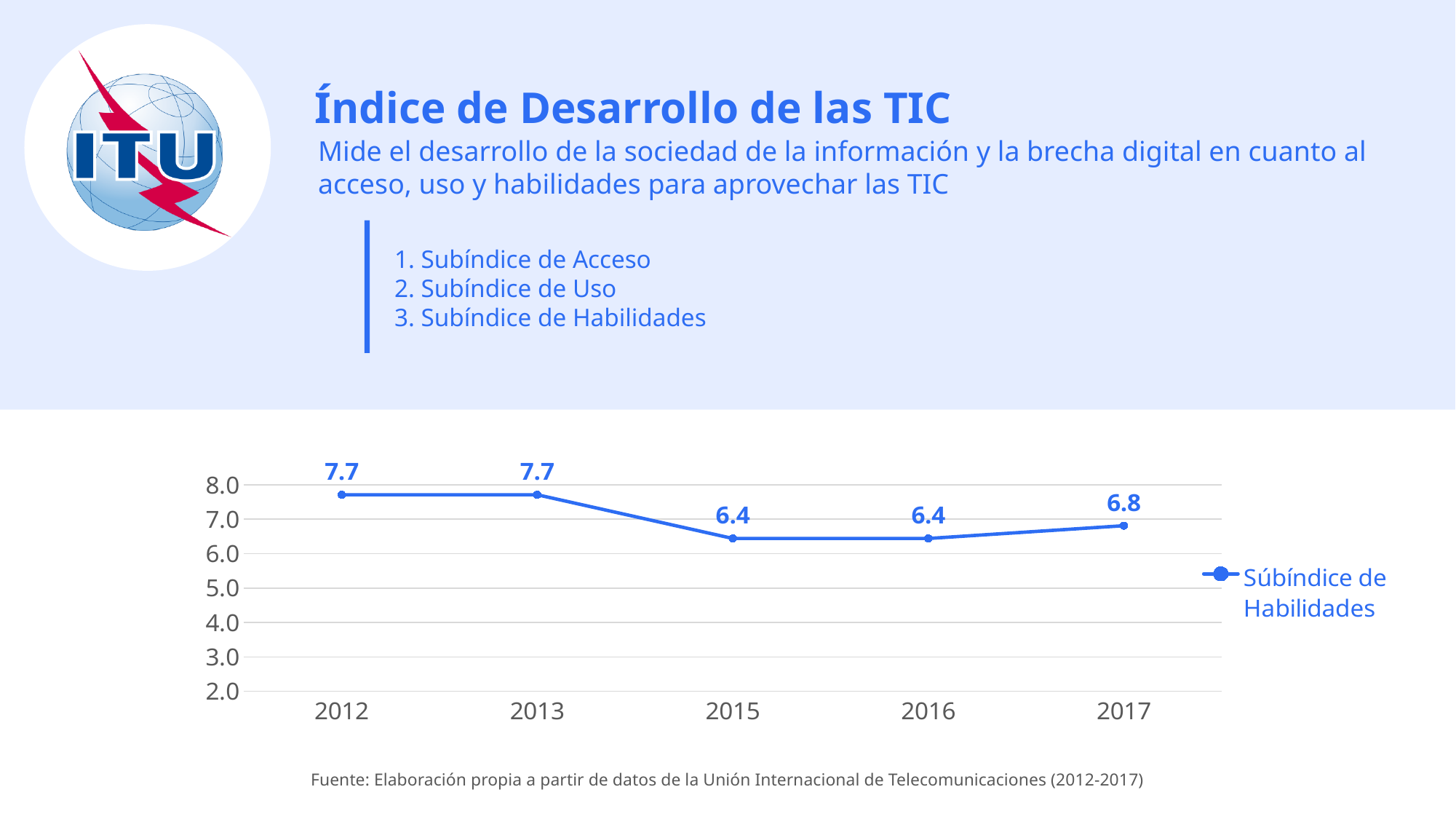
What is the value of the Subíndice de Habilidades in 2017? 6.8 Is the value for 2017 greater or less than 7.0? less What is the difference between the Subíndice de Habilidades values in 2017 and 2016? 0.4 Does the Subíndice de Habilidades rise or fall between 2013 and 2015? fall Which is larger, the Subíndice de Habilidades value in 2012 or in 2017? 2012 What is the difference between the Subíndice de Habilidades values in 2013 and 2015? 1.3 What is the value of the Subíndice de Habilidades in 2015? 6.4 What kind of chart is shown on the slide? line chart How many years are plotted on the chart? 5 What is the value of the Subíndice de Habilidades in 2012? 7.7 How many series does the legend list? 1 Which year has the lowest value of the Subíndice de Habilidades? 2015 and 2016 (both 6.4)